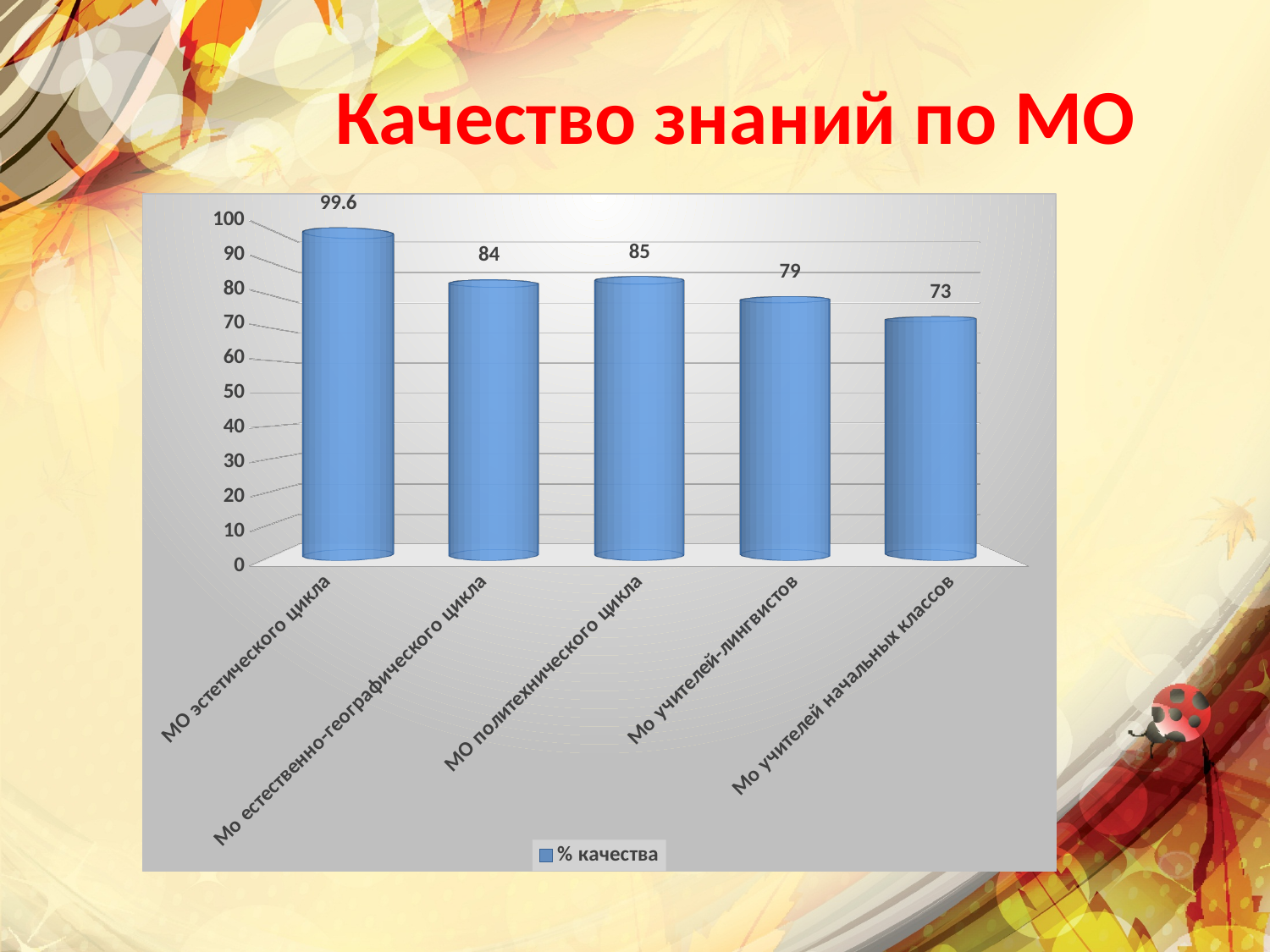
What is the value for Мо учителей-лингвистов? 79 Which is larger, the value for Мо учителей-лингвистов or the value for Мо учителей начальных классов? Мо учителей-лингвистов How many categories are shown in the chart? 5 What is the value for МО политехнического цикла? 85 What is the value for Мо естественно-географического цикла? 84 What kind of chart is shown on the slide? bar chart What is the value for Мо учителей начальных классов? 73 What is the value for МО эстетического цикла? 99.6 What series name does the legend show? % качества Which category has the lowest value? Мо учителей начальных классов Which category has the highest value? МО эстетического цикла What is the difference between the values for МО эстетического цикла and Мо учителей начальных классов? 26.6